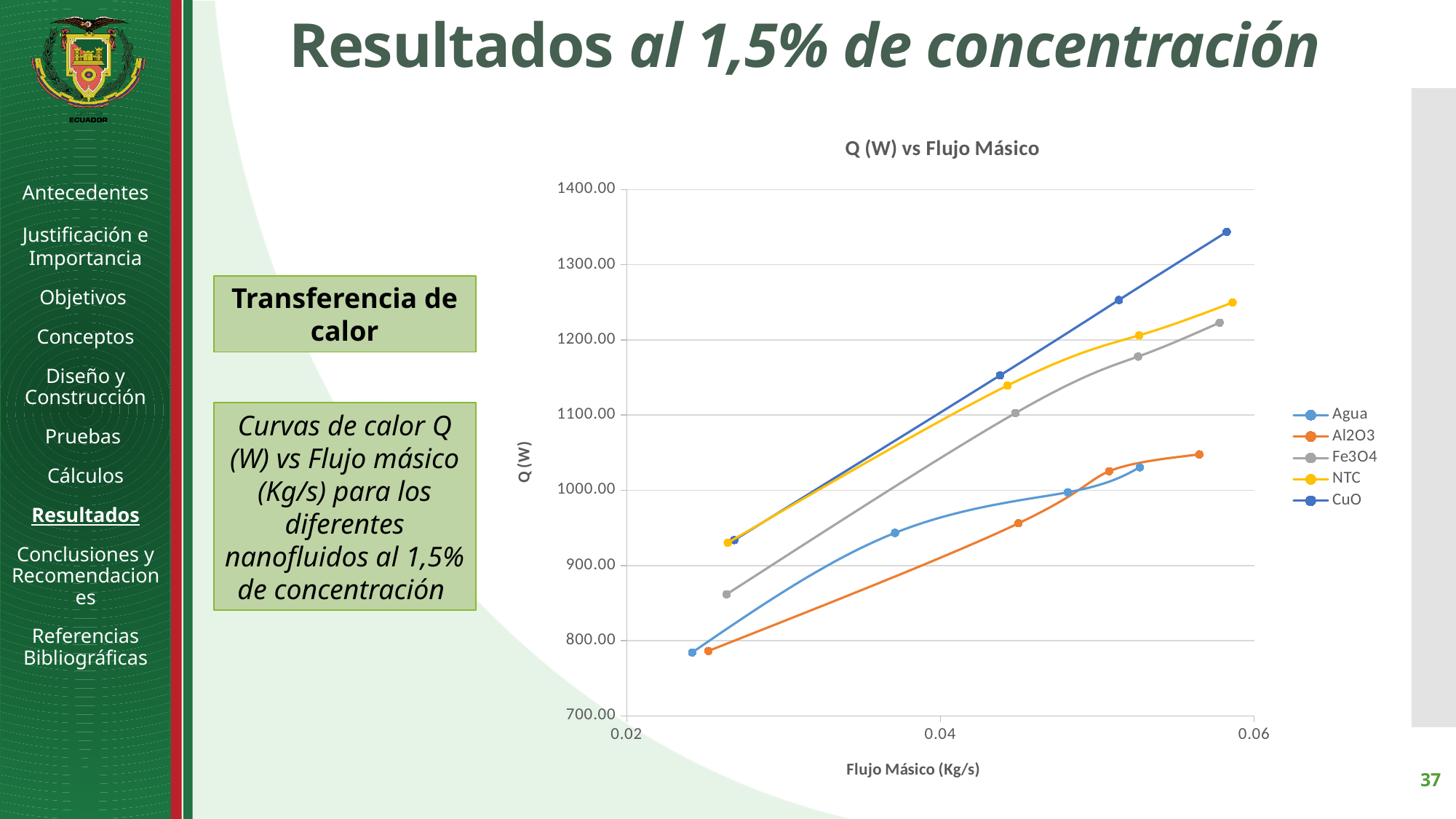
What is the label of the x axis? Flujo Másico (Kg/s) What is the title of the chart? Q (W) vs Flujo Másico Is the highest value of the CuO series greater or less than 1300? greater Do the Q (W) values for the CuO series rise or fall as Flujo Másico increases? rise Which series reaches the highest Q (W) value on the chart? CuO Is the last (rightmost) value of the Agua series greater or less than 1000? greater How many series does the legend list? 5 How many data points are plotted for the Agua series? 4 At their rightmost points, which series has the larger Q (W) value, Fe3O4 or Al2O3? Fe3O4 What kind of chart is shown on the slide? line chart At their rightmost points, which series has the larger Q (W) value, CuO or NTC? CuO Is the first (leftmost) value of the Fe3O4 series greater or less than 900? less